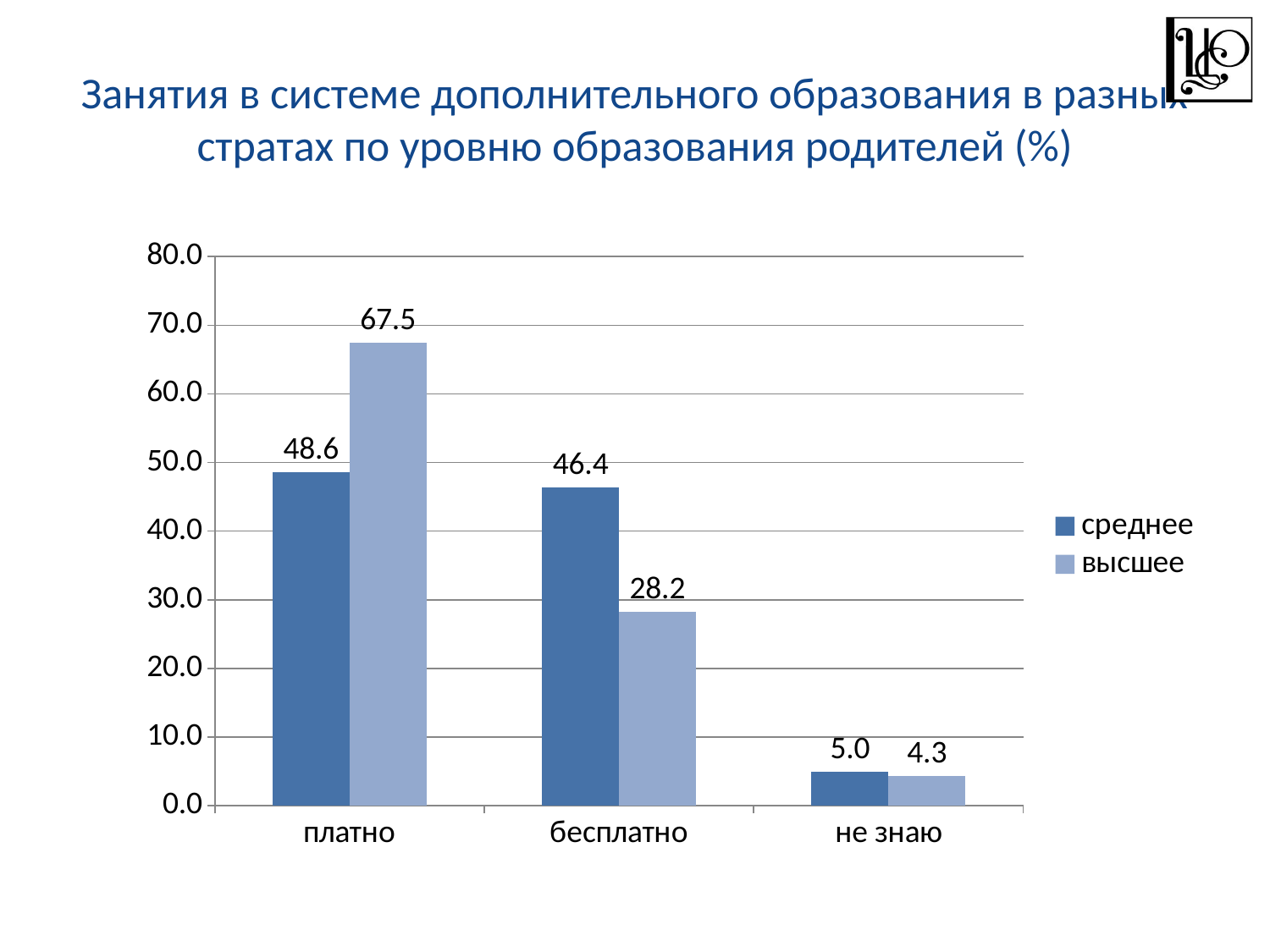
How many series does the legend list? 2 What is the difference between the "высшее" and "среднее" values in the "платно" category? 18.9 What is the value for "среднее" in the "бесплатно" category? 46.4 What is the difference between the "среднее" and "высшее" values in the "бесплатно" category? 18.2 In the "бесплатно" category, which series has the larger value, "среднее" or "высшее"? среднее What is the value for "высшее" in the "платно" category? 67.5 What kind of chart is shown on the slide? bar chart Which category has the lowest value for the "среднее" series? не знаю Which series is shown in the darker blue colour? среднее How many categories are shown on the x axis? 3 What is the value for "высшее" in the "не знаю" category? 4.3 Which category has the highest value for the "высшее" series? платно